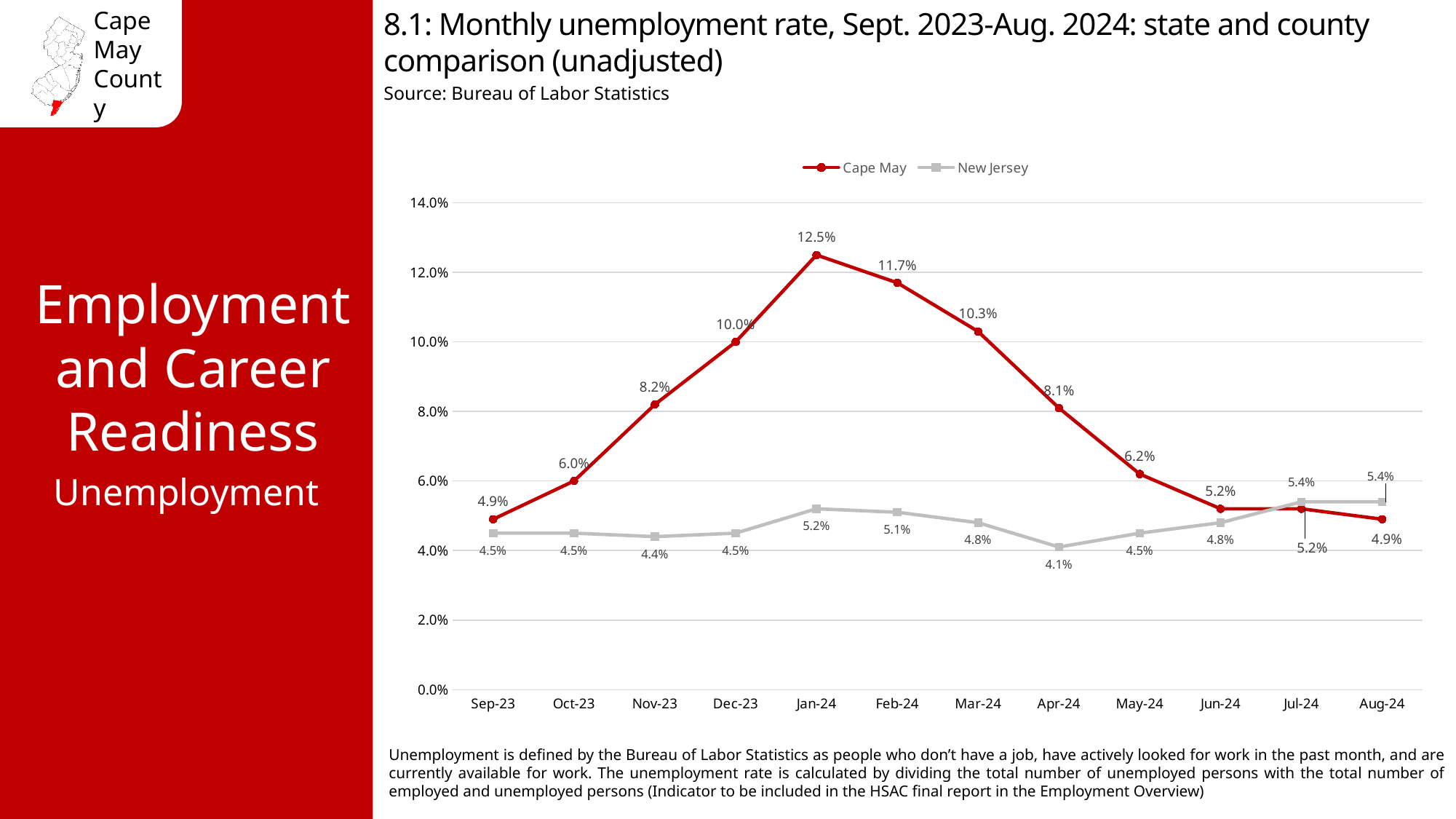
How many series does the legend list? 2 Did the Cape May unemployment rate rise or fall from Jan-24 to Aug-24? Fall What was the New Jersey unemployment rate in Apr-24? 4.1% Which series had the higher unemployment rate in Aug-24, Cape May or New Jersey? New Jersey What was the Cape May unemployment rate in Jan-24? 12.5% How many months are plotted on the x axis? 12 What was the Cape May unemployment rate in Nov-23? 8.2% Which series had the higher unemployment rate in Mar-24, Cape May or New Jersey? Cape May What kind of chart is shown on the slide? Line chart In which month did Cape May have its highest unemployment rate? Jan-24 In which month did New Jersey have its lowest unemployment rate? Apr-24 What is the difference between the Cape May and New Jersey unemployment rates in Jan-24? 7.3%